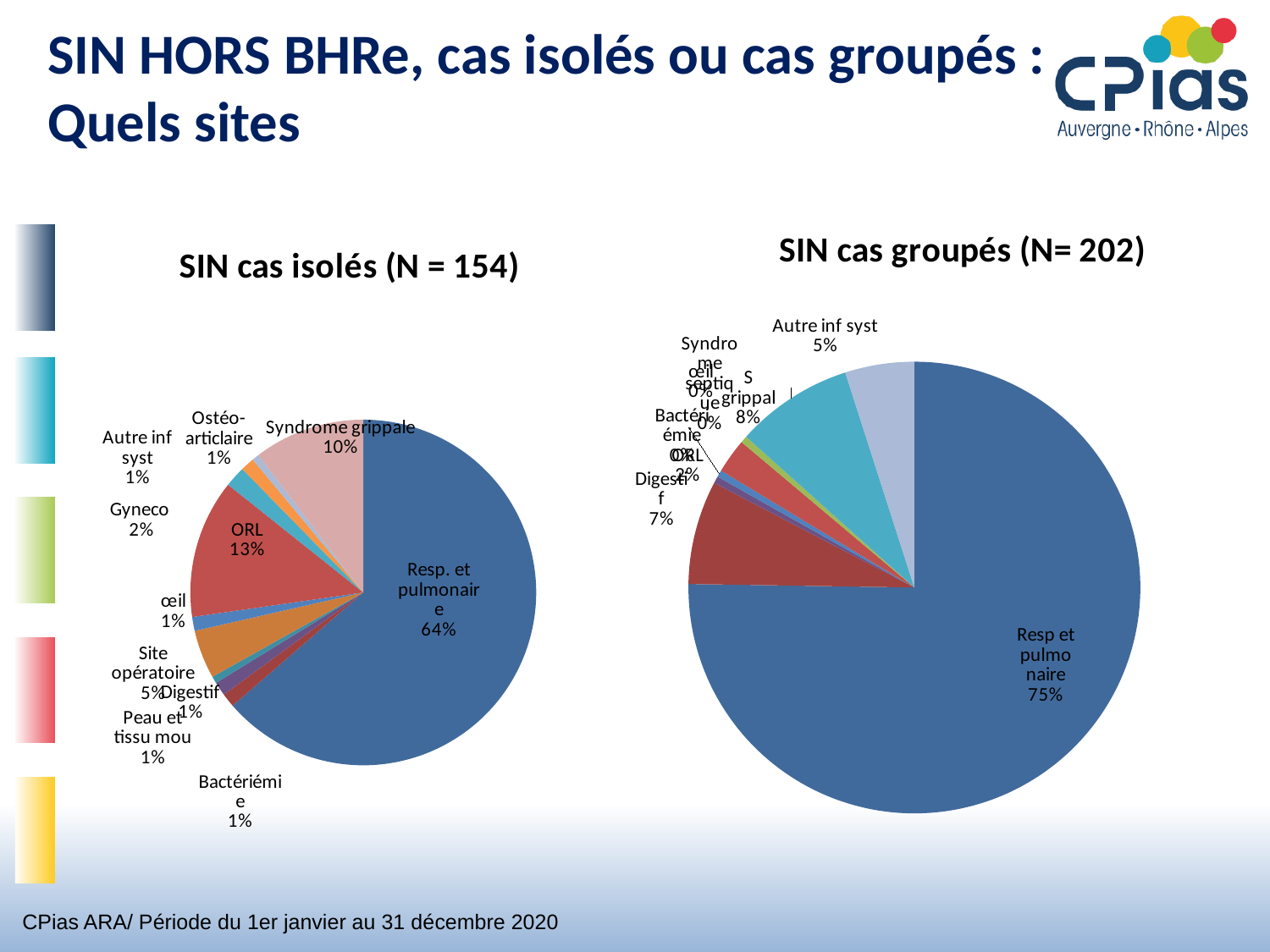
In the 'SIN cas isolés (N = 154)' chart, what percentage is shown for 'Gyneco'? 2% In the 'SIN cas isolés (N = 154)' chart, what share is 'Resp. et pulmonaire'? 64% In the 'SIN cas groupés (N= 202)' chart, what percentage is shown for 'Digestif'? 7% In the 'SIN cas isolés (N = 154)' chart, what is the difference in percentage points between 'ORL' and 'Syndrome grippale'? 3 What type of chart is used for 'SIN cas isolés (N = 154)'? Pie chart In the 'SIN cas isolés (N = 154)' chart, what percentage is shown for 'ORL'? 13% In the 'SIN cas groupés (N= 202)' chart, what percentage is shown for 'Autre inf syst'? 5% Which is larger: 'Resp et pulmonaire' in the 'SIN cas groupés (N= 202)' chart or 'Resp. et pulmonaire' in the 'SIN cas isolés (N = 154)' chart? SIN cas groupés (N= 202) In the 'SIN cas isolés (N = 154)' chart, what percentage is shown for 'Syndrome grippale'? 10% In the 'SIN cas groupés (N= 202)' chart, what share is 'Resp et pulmonaire'? 75% In the 'SIN cas isolés (N = 154)' chart, what percentage is shown for 'Site opératoire'? 5% In the 'SIN cas isolés (N = 154)' chart, which category has the largest share? Resp. et pulmonaire